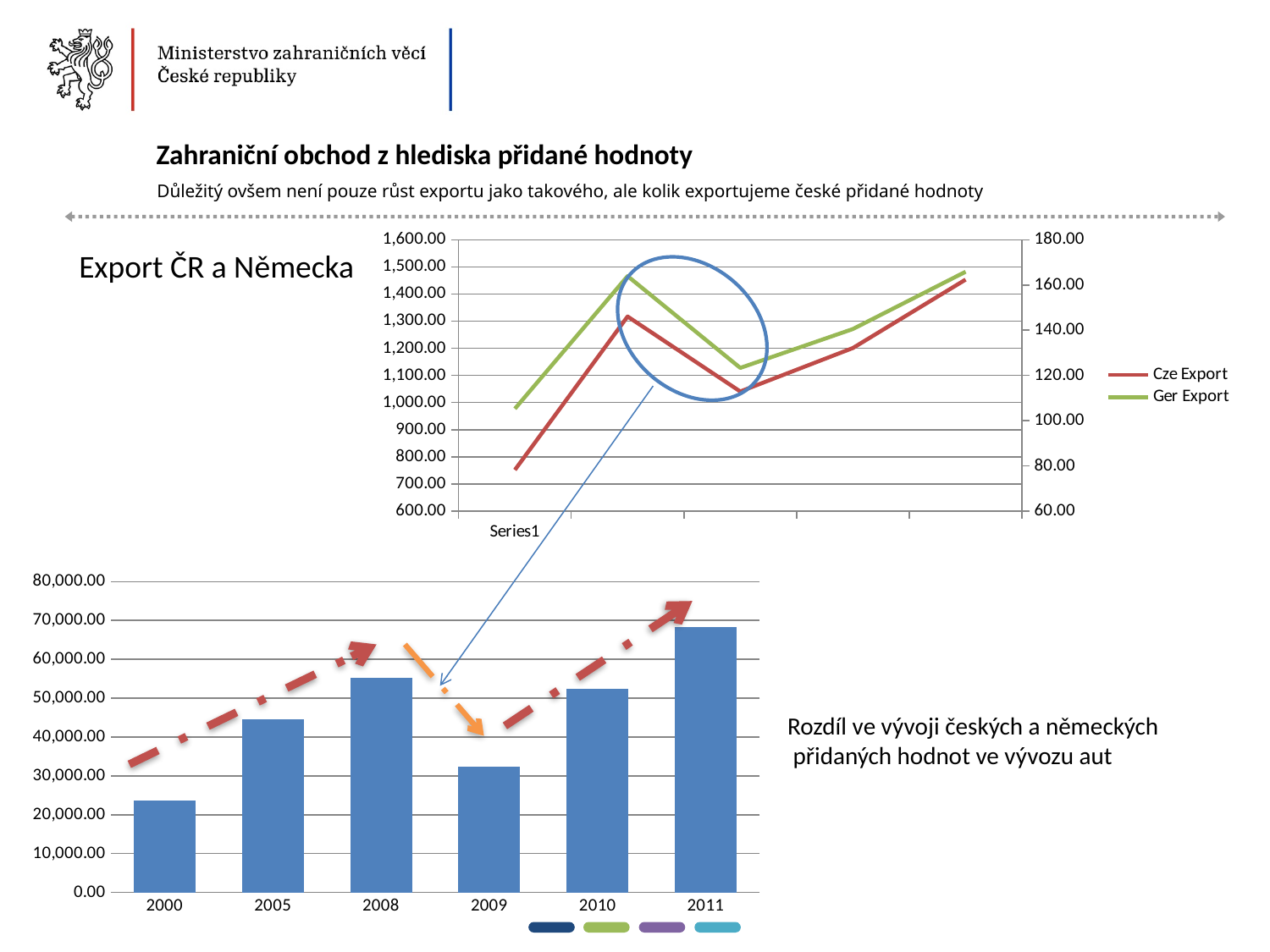
In the bottom bar chart, which year has the lowest value? 2000 What kind of chart is the bottom chart with years on the x axis? bar chart In the bottom bar chart, is the value for 2011 greater or less than 60,000.00? greater In the bottom bar chart, which is larger, the value for 2005 or the value for 2009? 2005 In the bottom bar chart, do the values rise or fall from 2009 to 2011? rise In the bottom bar chart, is the value for 2009 greater or less than 40,000.00? less What kind of chart is the top chart titled 'Export ČR a Německa'? line chart In the bottom bar chart, how many years are shown on the x axis? 6 In the bottom bar chart, which year has the highest value? 2011 In the bottom bar chart, is the value for 2008 greater or less than 50,000.00? greater In the top chart 'Export ČR a Německa', how many series does the legend list? 2 In the top chart 'Export ČR a Německa', which series is drawn in green? Ger Export